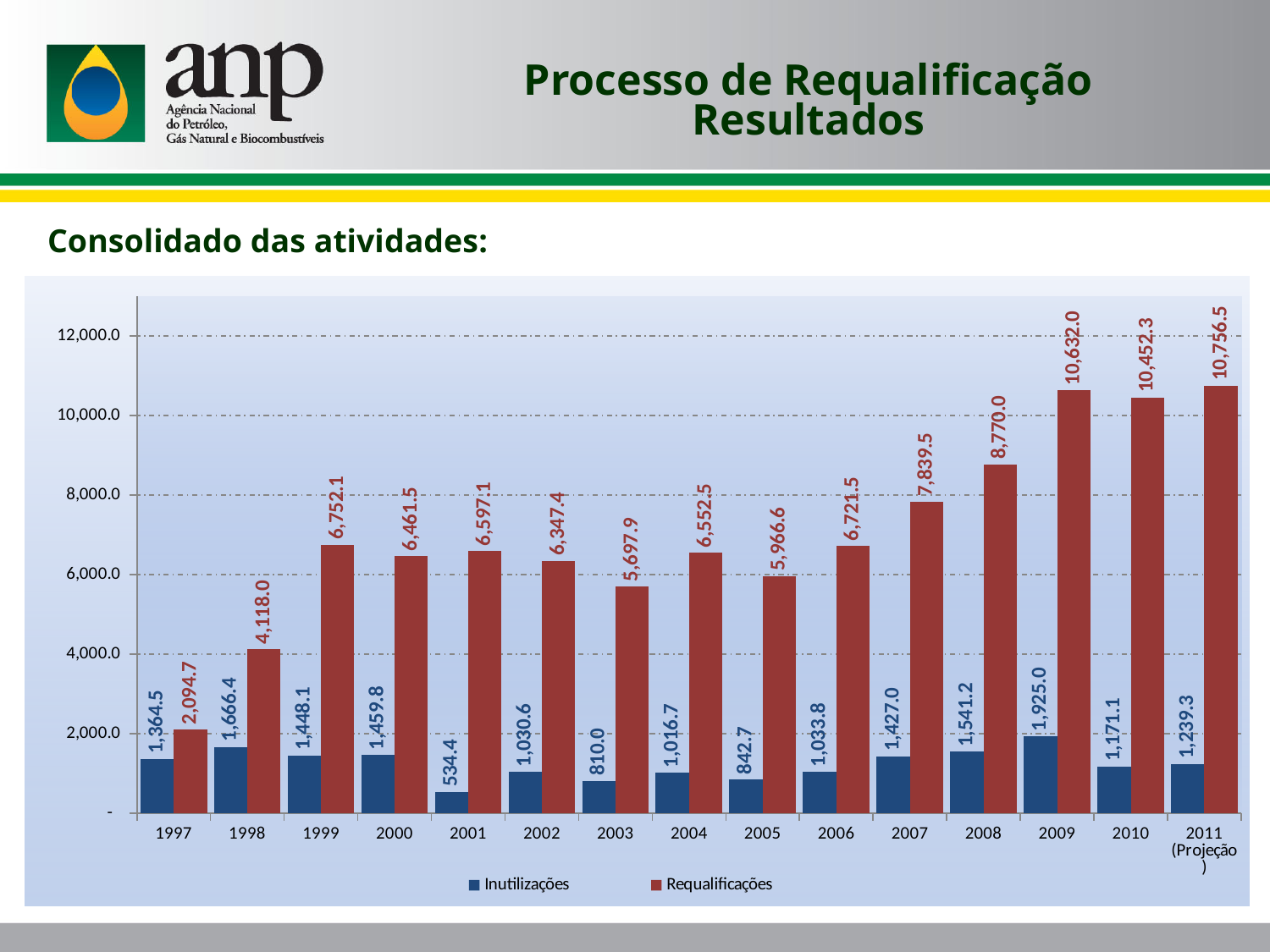
Which is larger: Requalificações in 2009 or Requalificações in 2010? Requalificações in 2009 What is the value of Requalificações for 1997? 2,094.7 What is the difference between Requalificações and Inutilizações in 2011 (Projeção)? 9,517.2 What kind of chart is shown on the slide? Bar chart Which year has the lowest value for Inutilizações? 2001 What is the value of Requalificações for 2009? 10,632.0 How many years are shown on the x axis? 15 Which year has the highest value for Requalificações? 2011 (Projeção) Is the value of Requalificações for 2008 greater or less than 8,000.0? greater What is the value of Inutilizações for 2001? 534.4 How many series does the legend list? 2 Which year has the highest value for Inutilizações? 2009